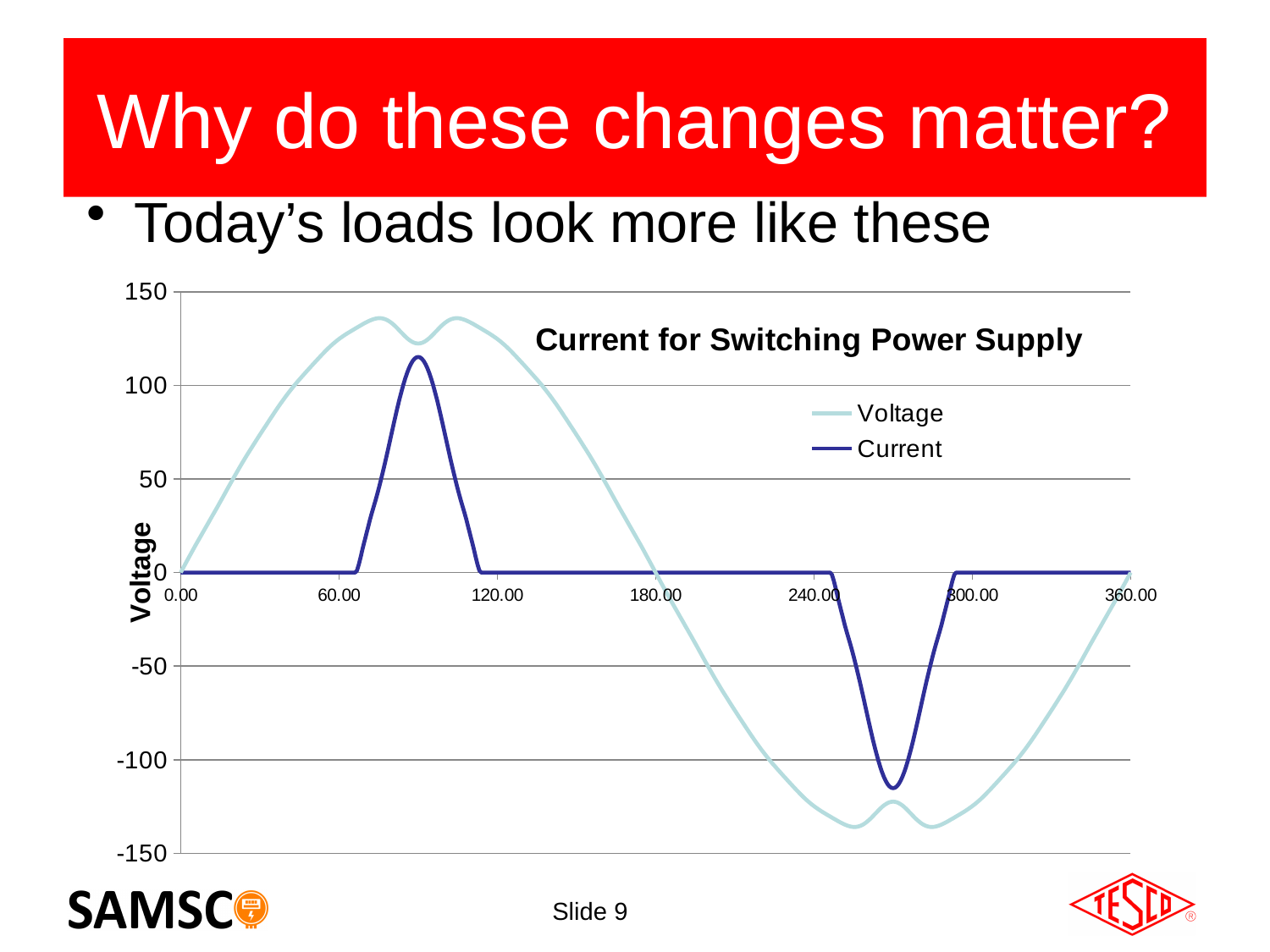
Is the lowest value of the Voltage series greater or less than -100? less How many series does the legend list? 2 What are the two series named in the legend? Voltage and Current What kind of chart is shown on the slide? line chart What is the title of the chart? Current for Switching Power Supply What is the value of the Current series at 0.00 on the x axis? 0 Is the peak value of the Current series greater or less than 150? less What is the value of the Current series at 180.00 on the x axis? 0 Which series reaches the higher peak value, Voltage or Current? Voltage Is the peak value of the Voltage series greater or less than 100? greater What is the value of the Voltage series at 180.00 on the x axis? 0 Does the Voltage series rise or fall between 0.00 and 60.00 on the x axis? rise